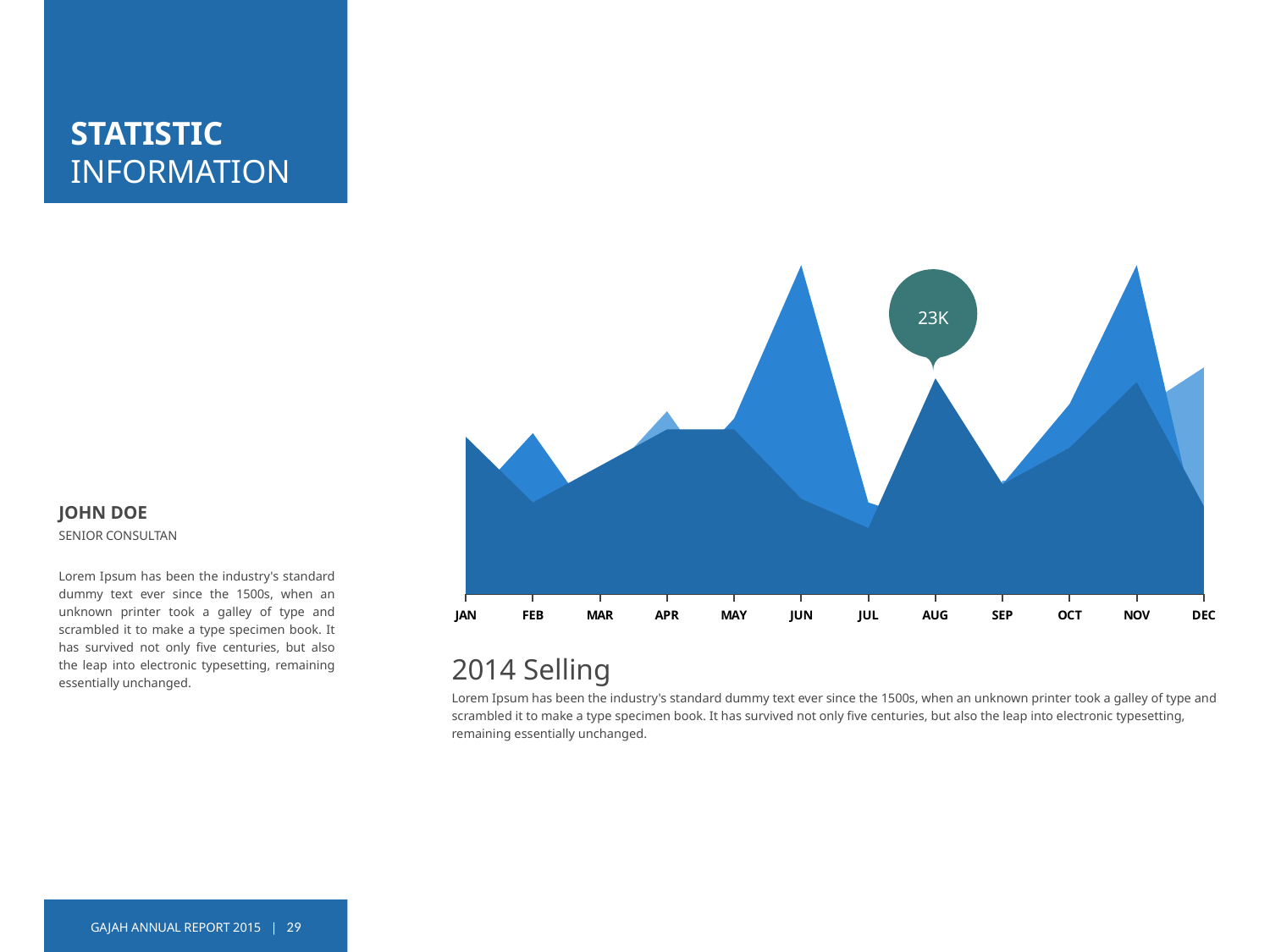
Is the dark blue area higher in MAY or in JUL? MAY Which month is labelled with the 23K callout? AUG What is the first month label on the x axis? JAN Does the dark blue area rise or fall from NOV to DEC? fall Is the dark blue area higher in AUG or in SEP? AUG Does the dark blue area rise or fall from JAN to FEB? fall What is the title printed below the chart? 2014 Selling How many months are shown along the x axis of the chart? 12 What kind of chart is shown on the slide? area chart What value is shown in the callout label above AUG? 23K In which month does the dark blue area reach its lowest point? JUL Does the dark blue area rise or fall from SEP to NOV? rise